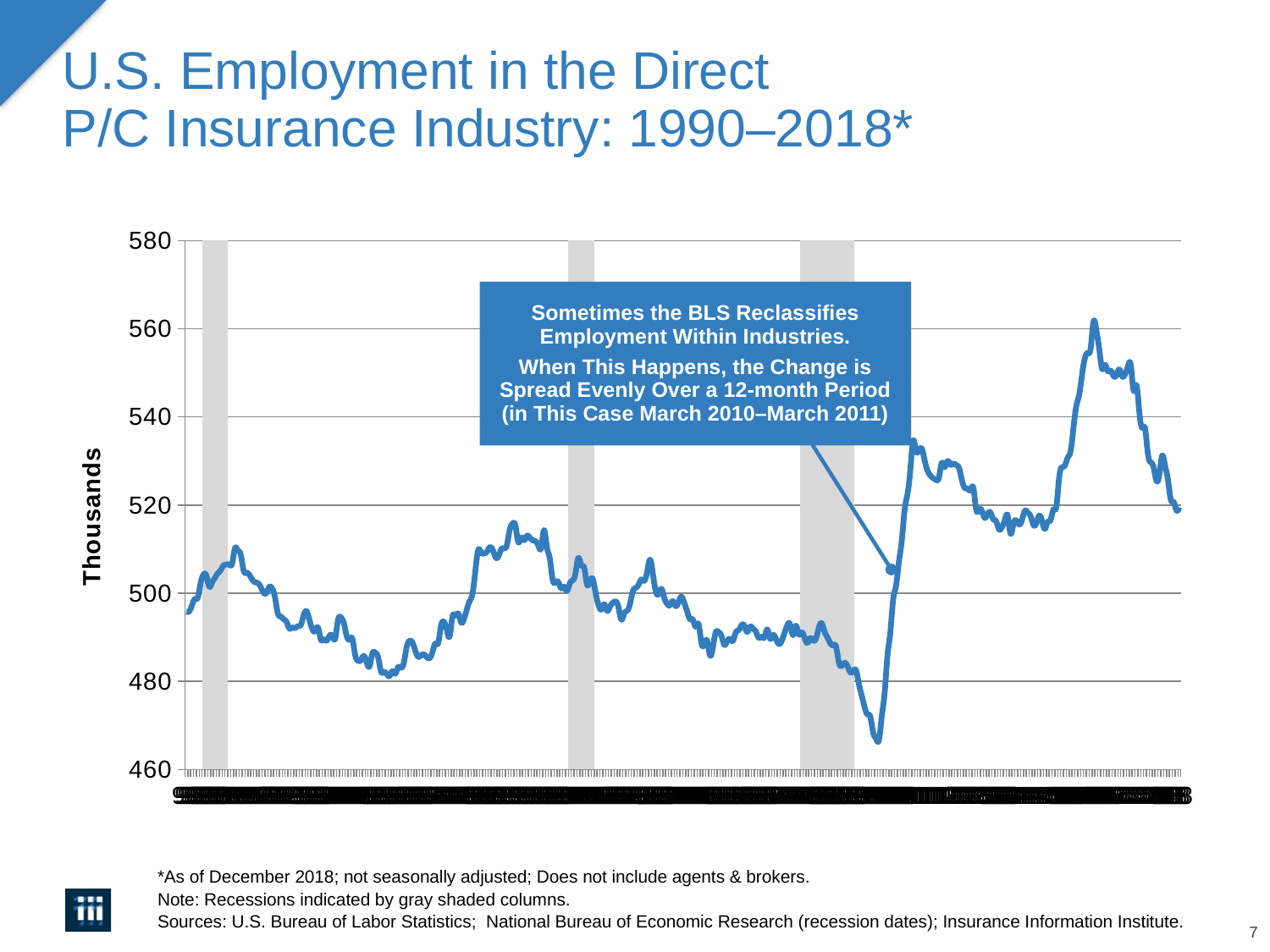
Is the lowest point of the line greater or less than 460? greater Is the highest point of the line greater or less than 540? greater Is the value at the far right end of the line greater or less than 500? greater What is the title of the chart on the slide? U.S. Employment in the Direct P/C Insurance Industry: 1990–2018* What is the highest value shown on the vertical axis? 580 How many gray shaded recession columns appear on the chart? 3 What is the label on the vertical axis of the chart? Thousands Comparing the start of the line to its end, does employment rise or fall overall across the chart? rise What kind of chart is shown on the slide? Line chart